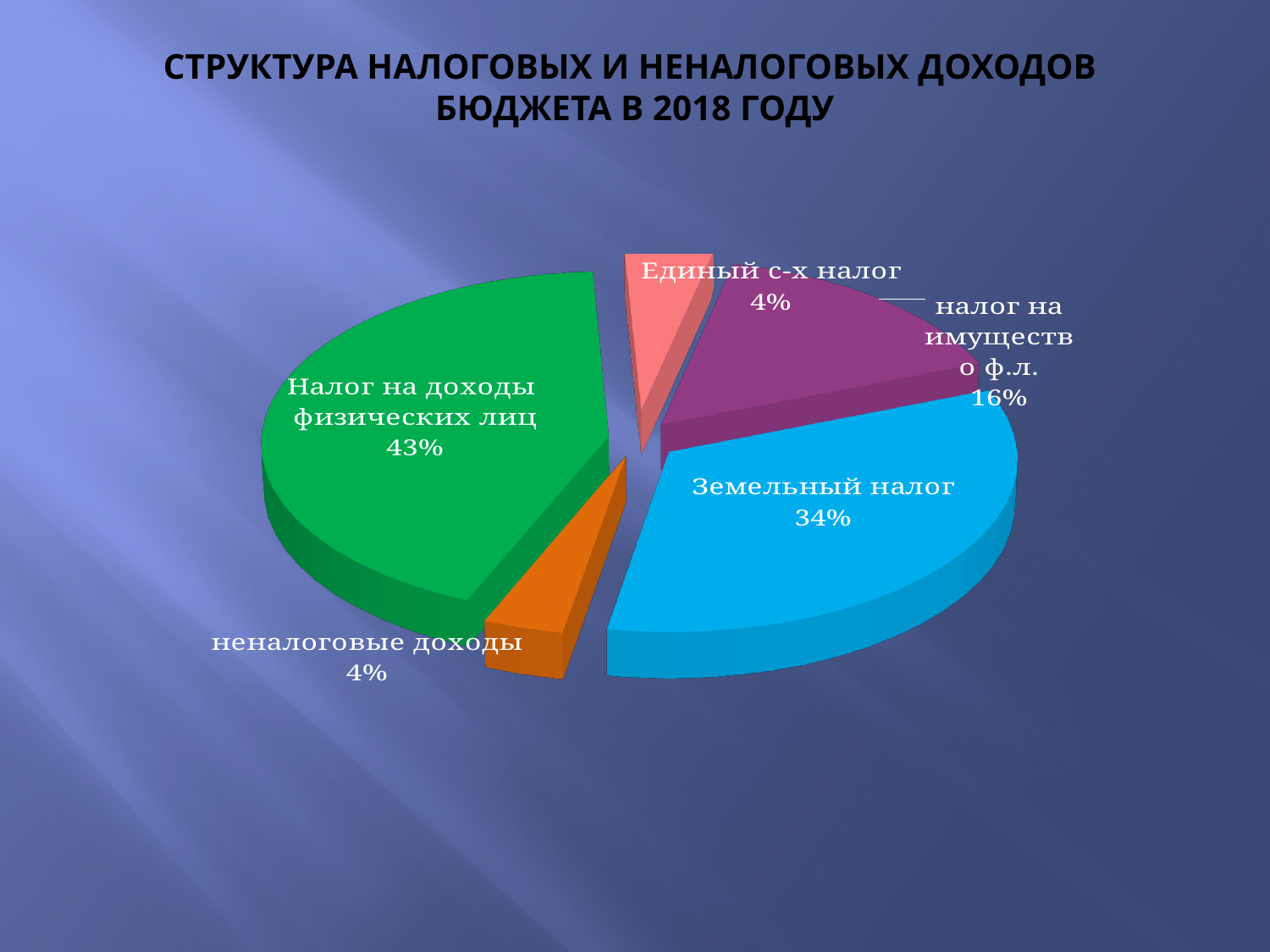
What is the title of the slide? СТРУКТУРА НАЛОГОВЫХ И НЕНАЛОГОВЫХ ДОХОДОВ БЮДЖЕТА В 2018 ГОДУ What is the difference in percentage points between "налог на имущество ф.л." and "Единый с-х налог"? 12 What share of the pie is "Налог на доходы физических лиц"? 43% What share of the pie is "неналоговые доходы"? 4% How many slices does the pie chart have? 5 Which slice of the pie is the largest? Налог на доходы физических лиц What is the difference in percentage points between "Налог на доходы физических лиц" and "Земельный налог"? 9 What share of the pie is "налог на имущество ф.л."? 16% Which is larger, "Земельный налог" or "налог на имущество ф.л."? Земельный налог What kind of chart is shown on the slide? Pie chart